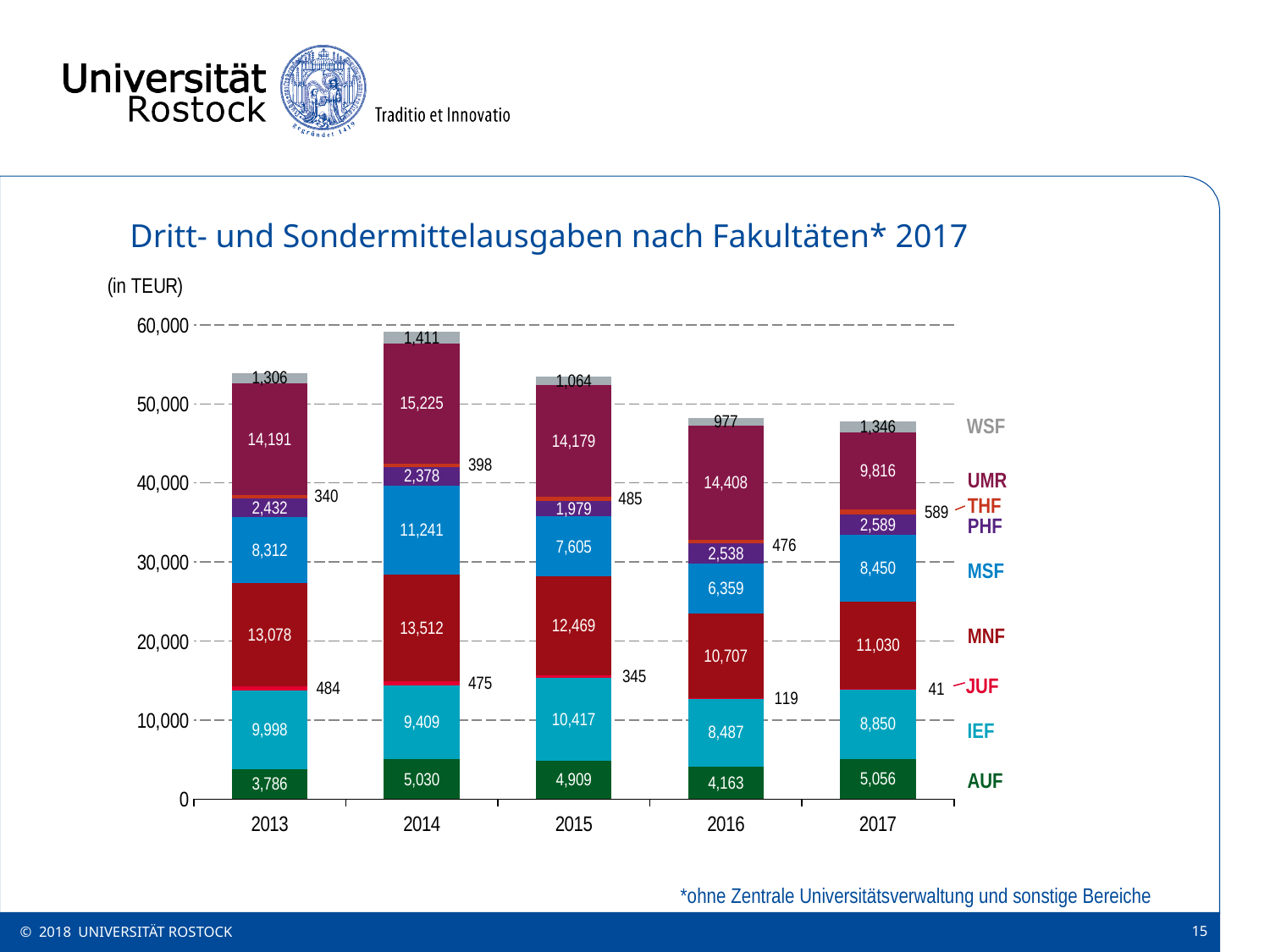
What was the IEF value in 2015? 10,417 Which was larger in 2016, the MSF value or the IEF value? IEF What was the WSF value in 2017? 1,346 What was the MNF value in 2014? 13,512 What is the difference between the MNF value in 2013 and in 2017? 2,048 In which year was the JUF value lowest? 2017 Does the JUF value rise or fall from 2013 to 2017? fall How many years are shown on the x axis? 5 In which year was the UMR value highest? 2014 What kind of chart is shown on the slide? stacked bar chart How many faculties (series) does the legend list? 9 Is the total of the 2014 bar greater or less than 50,000? greater